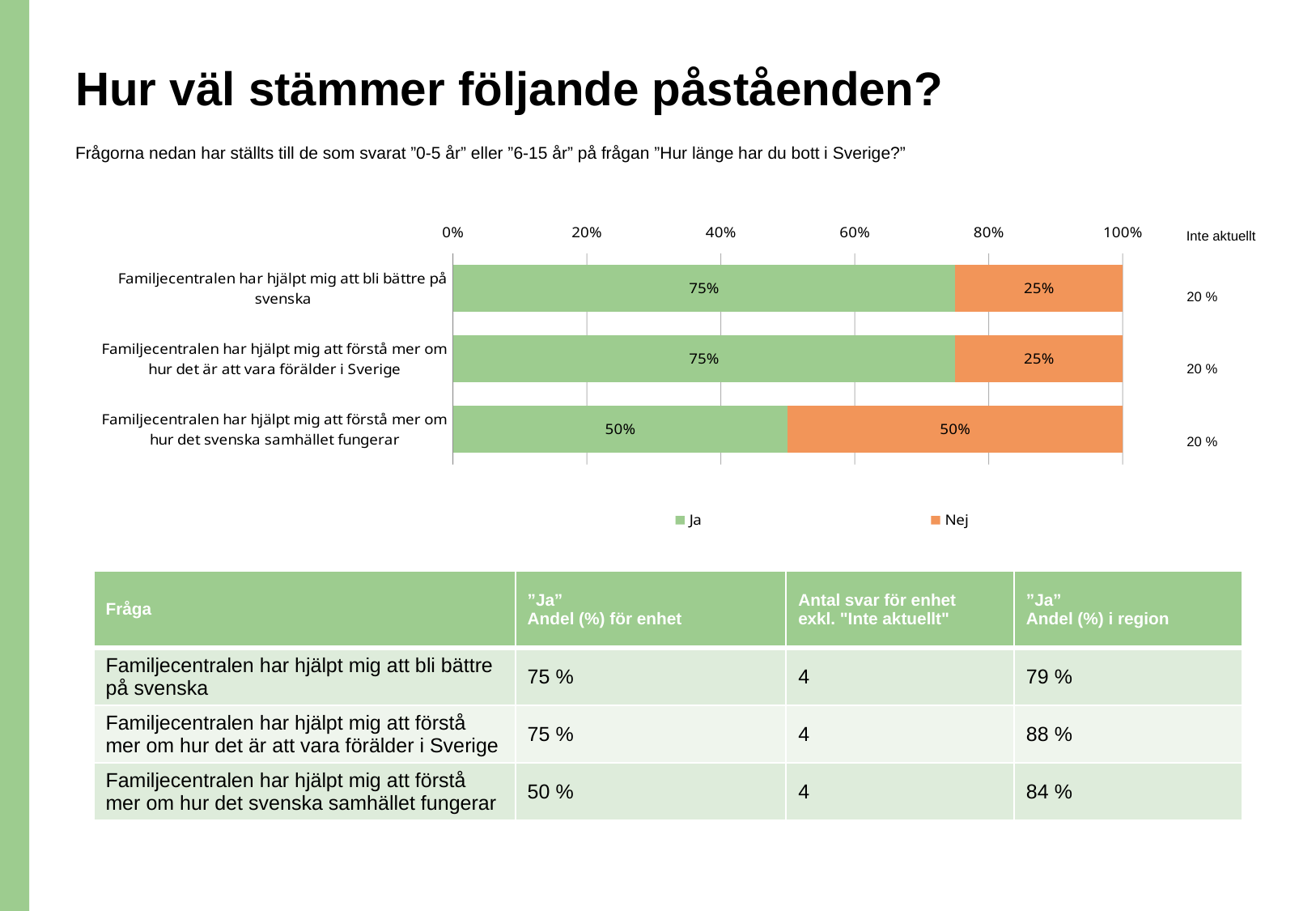
How many statements (categories) are shown in the chart? 3 Which statement has the highest "Nej" share? Familjecentralen har hjälpt mig att förstå mer om hur det svenska samhället fungerar Which statement has the lowest "Ja" share? Familjecentralen har hjälpt mig att förstå mer om hur det svenska samhället fungerar Is the "Ja" share larger for "Familjecentralen har hjälpt mig att bli bättre på svenska" or for "Familjecentralen har hjälpt mig att förstå mer om hur det svenska samhället fungerar"? Familjecentralen har hjälpt mig att bli bättre på svenska What is the "Inte aktuellt" value shown next to the bar for "Familjecentralen har hjälpt mig att förstå mer om hur det är att vara förälder i Sverige"? 20 % What type of chart is shown on the slide? Stacked bar chart What percentage answered "Ja" to "Familjecentralen har hjälpt mig att bli bättre på svenska"? 75% What percentage answered "Nej" to "Familjecentralen har hjälpt mig att förstå mer om hur det svenska samhället fungerar"? 50% What is the "Nej" value for "Familjecentralen har hjälpt mig att förstå mer om hur det är att vara förälder i Sverige"? 25% Which colour represents the "Nej" series in the chart? Orange How many series does the chart legend list? 2 What is the difference between the "Ja" and "Nej" shares for "Familjecentralen har hjälpt mig att bli bättre på svenska"? 50%